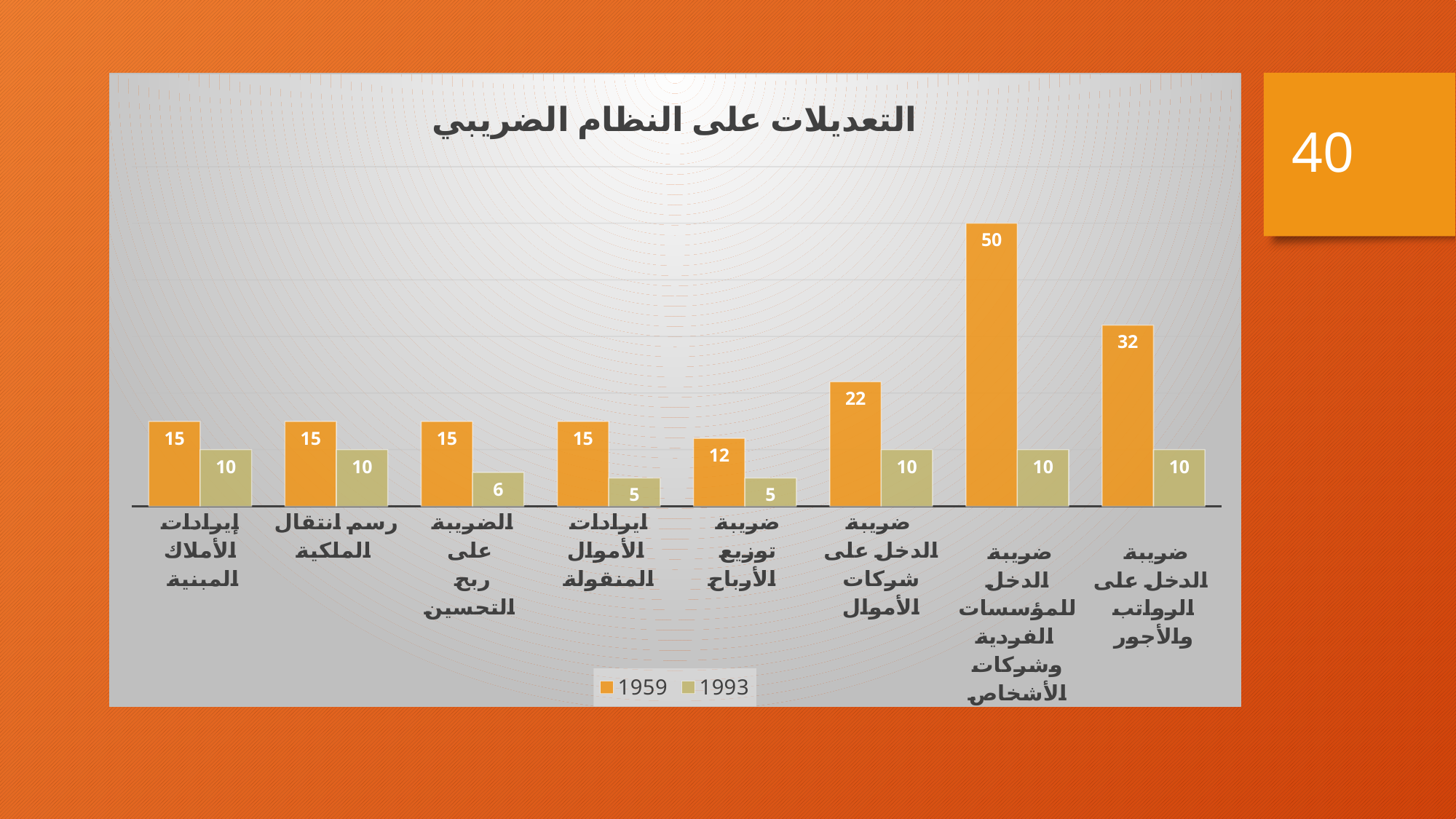
What kind of chart is shown on the slide? Bar chart What is the title of the chart? التعديلات على النظام الضريبي How many categories are shown on the x axis? 8 What is the 1993 value for الضريبة على ربح التحسين? 6 What is the difference between the 1959 and 1993 values for ضريبة الدخل للمؤسسات الفردية وشركات الأشخاص? 40 Which category has the highest 1959 value? ضريبة الدخل للمؤسسات الفردية وشركات الأشخاص Which category has the lowest 1959 value? ضريبة توزيع الأرباح Which is larger: the 1993 value for إيرادات الأموال المنقولة or the 1993 value for إيرادات الأملاك المبنية? إيرادات الأملاك المبنية What is the 1959 value for ضريبة الدخل على الرواتب والأجور? 32 What is the difference between the 1959 values for ضريبة الدخل على الرواتب والأجور and ضريبة الدخل على شركات الأموال? 10 What is the 1959 value for ضريبة توزيع الأرباح? 12 How many series does the legend list? 2